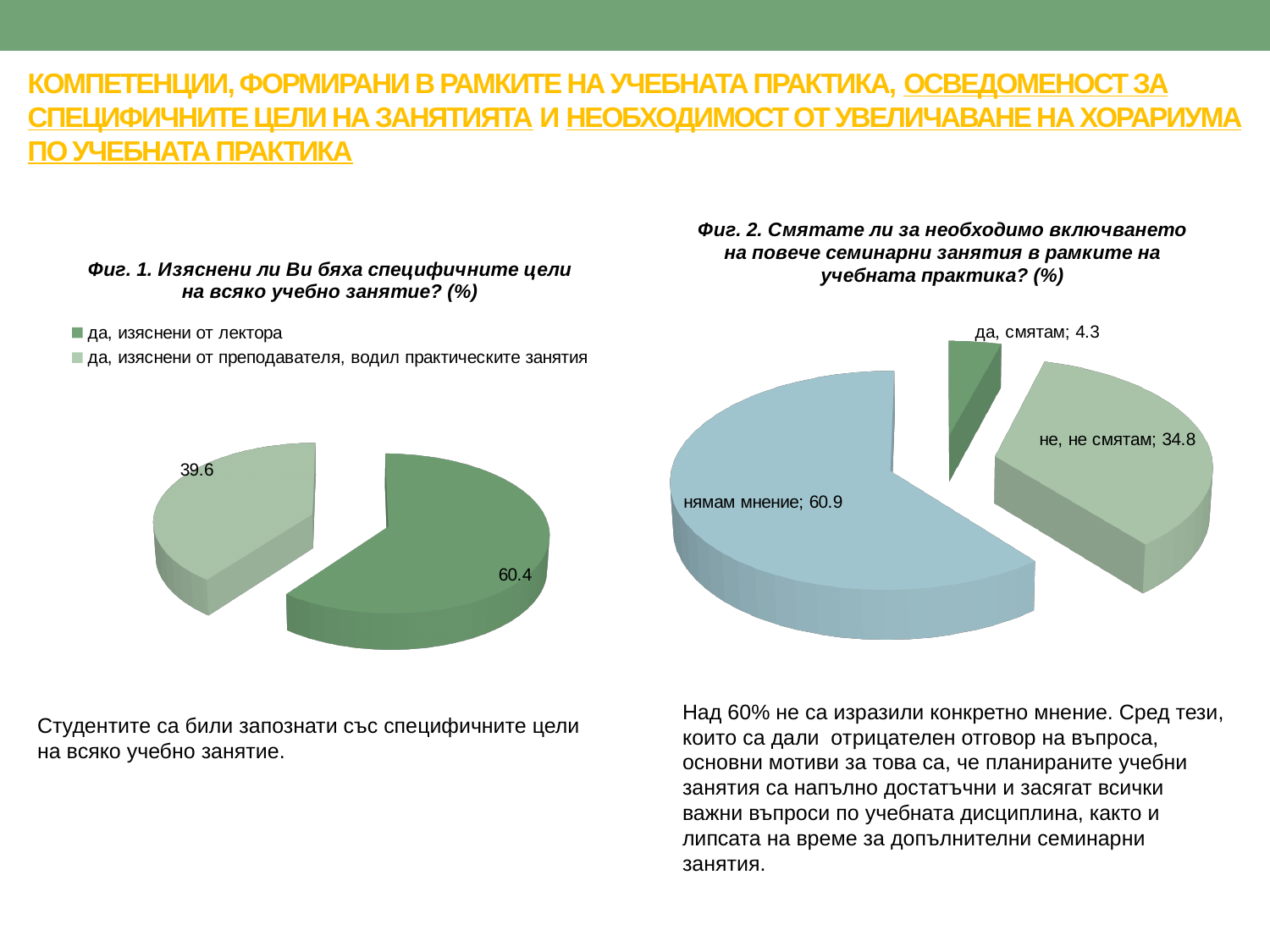
In the right chart (Фиг. 2), what is the value for 'да, смятам'? 4.3 What type of chart is the left chart (Фиг. 1)? Pie chart In the right chart (Фиг. 2), how many categories are shown? 3 In the right chart (Фиг. 2), what is the value for 'нямам мнение'? 60.9 In the right chart (Фиг. 2), what is the value for 'не, не смятам'? 34.8 In the left chart (Фиг. 1), which category has the largest slice? да, изяснени от лектора In the left chart (Фиг. 1), what is the value for 'да, изяснени от лектора'? 60.4 In the left chart (Фиг. 1), what is the value for 'да, изяснени от преподавателя, водил практическите занятия'? 39.6 In the left chart (Фиг. 1), what is the difference between the two slice values? 20.8 In the right chart (Фиг. 2), what is the difference between 'нямам мнение' and 'не, не смятам'? 26.1 In the right chart (Фиг. 2), which category has the smallest slice? да, смятам In the left chart (Фиг. 1), how many slices does the pie have? 2